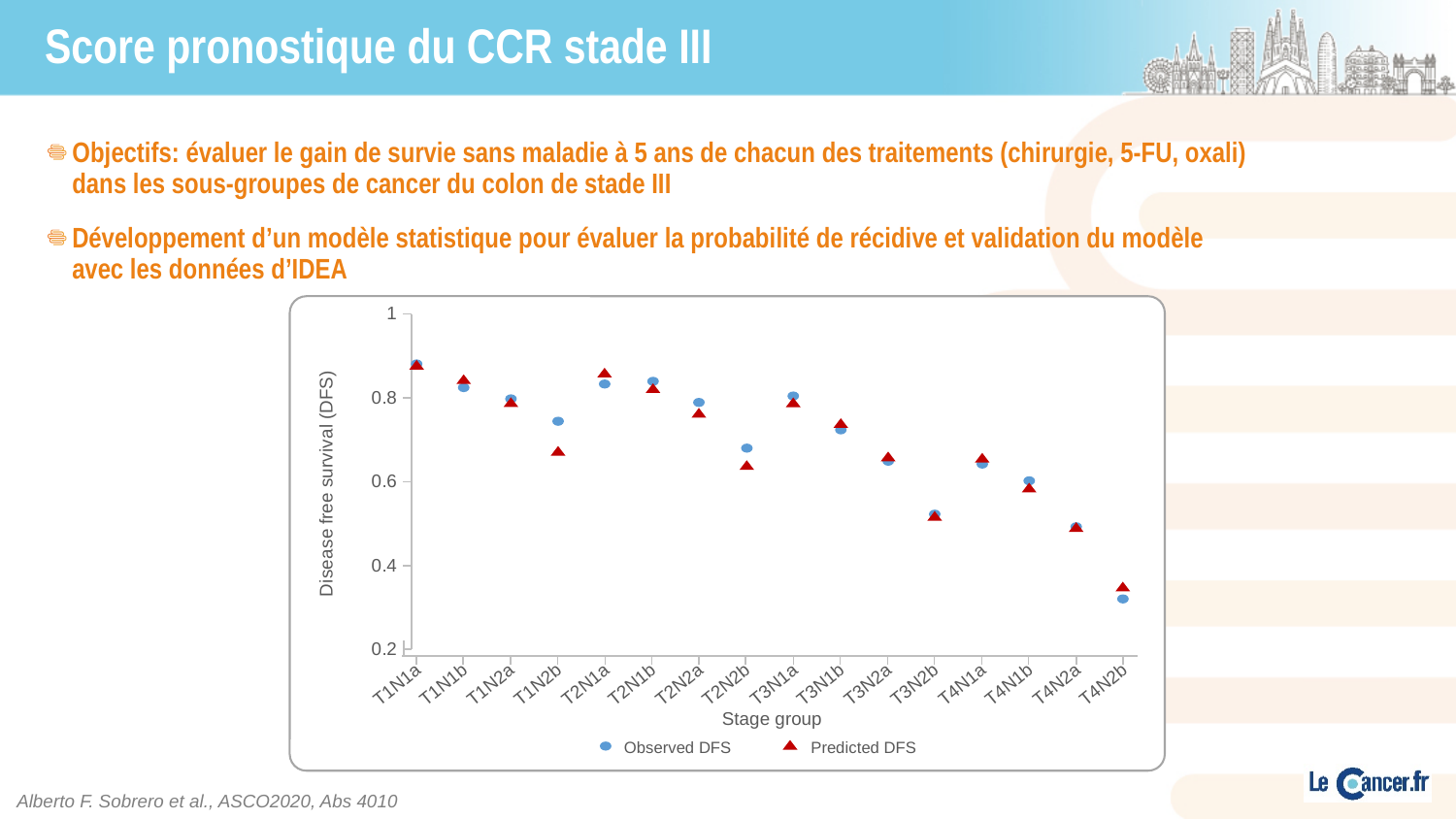
How many series does the chart legend list? 2 Which stage group has the lowest Observed DFS? T4N2b Is the Predicted DFS for T1N2b greater or less than 0.6? greater What kind of chart is shown on the slide? scatter chart What is the title of the x axis of the chart? Stage group How many stage groups are plotted along the x axis? 16 Overall, do the Observed DFS values rise or fall from T1N1a to T4N2b along the x axis? fall For stage group T1N2b, which is larger: Observed DFS or Predicted DFS? Observed DFS For stage group T2N2b, which is larger: Observed DFS or Predicted DFS? Observed DFS Is the Observed DFS for T3N2b greater or less than 0.6? less Which stage group has the highest Observed DFS? T1N1a Is the Observed DFS for T4N2b greater or less than 0.4? less